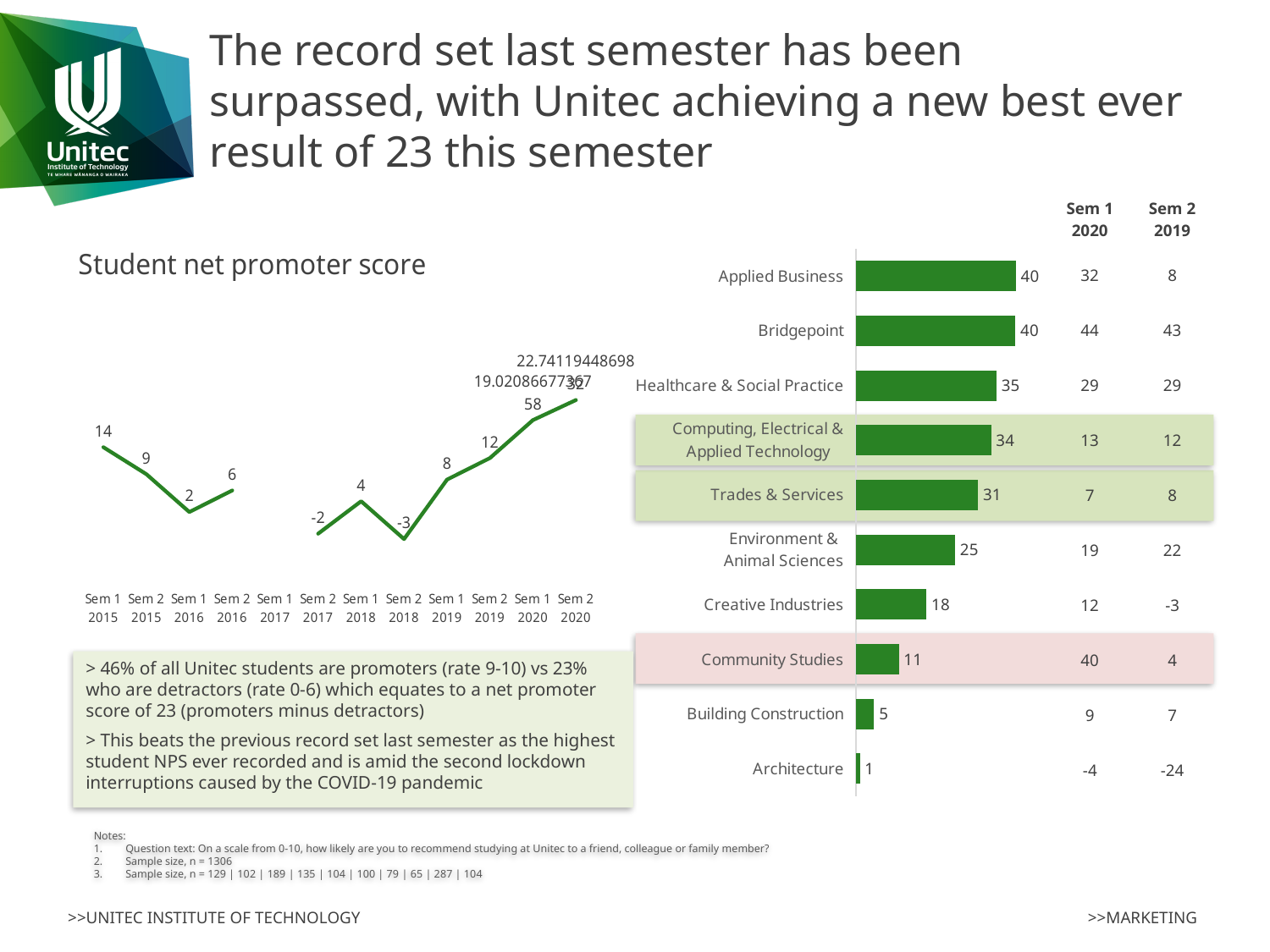
What kind of chart is the Student net promoter score chart? Line chart What kind of chart is the chart on the right of the slide? Bar chart How many categories are shown in the bar chart on the right? 10 How many data points are plotted in the Student net promoter score chart? 11 In the bar chart on the right, which category has the lowest value? Architecture In the Student net promoter score chart, what is the value for Sem 1 2015? 14 In the bar chart on the right, what is the value for Community Studies? 11 In the Student net promoter score chart, which period has the lowest value? Sem 2 2018 In the bar chart on the right, which is larger: Environment & Animal Sciences or Creative Industries? Environment & Animal Sciences In the Student net promoter score chart, what is the value for Sem 1 2018? 4 In the bar chart on the right, what is the difference between the values for Healthcare & Social Practice and Trades & Services? 4 In the bar chart on the right, what is the value for Healthcare & Social Practice? 35